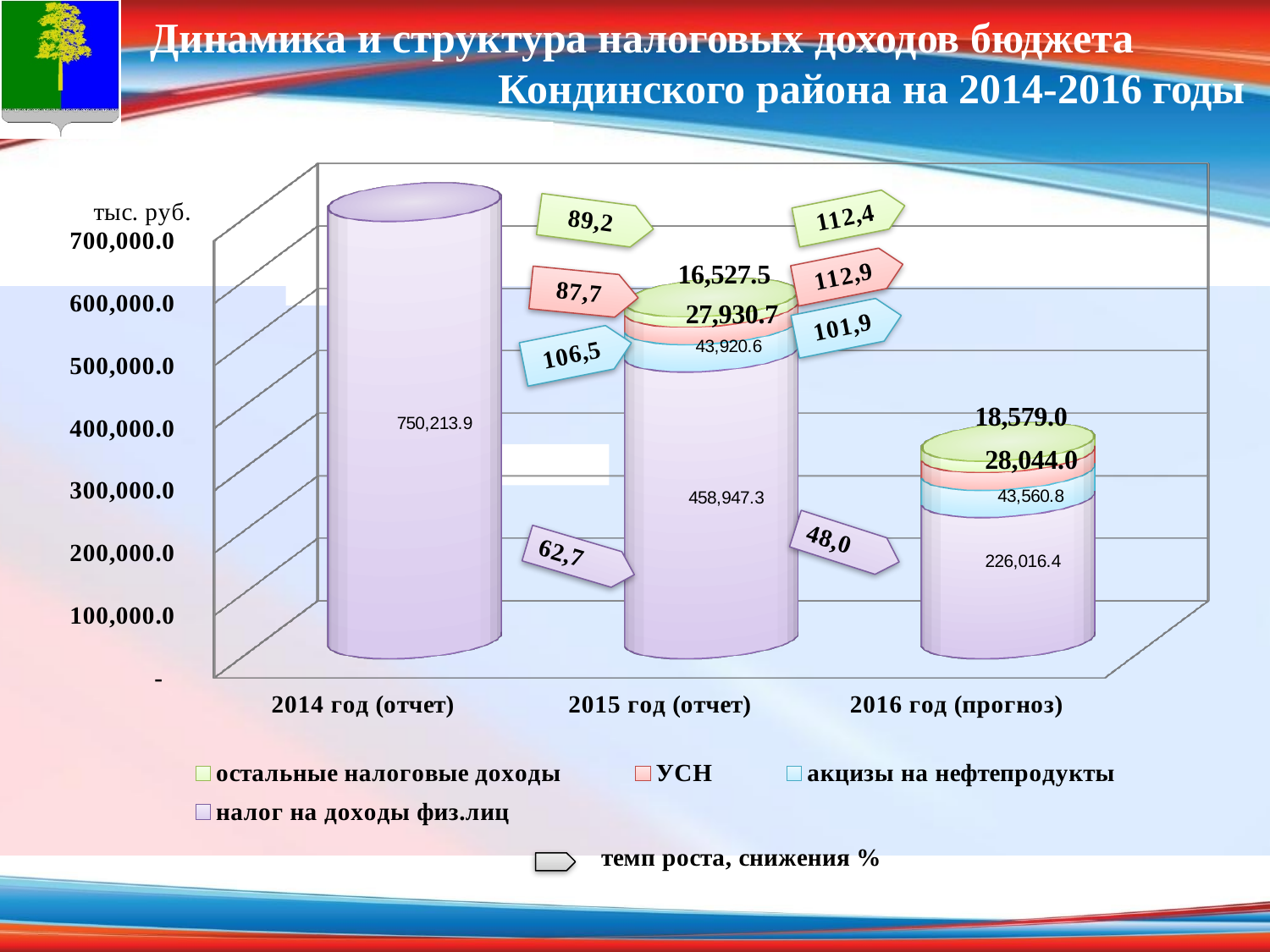
Which is larger: остальные налоговые доходы in 2015 год (отчет) or in 2016 год (прогноз)? 2016 год (прогноз) What is the difference in налог на доходы физ.лиц between 2015 год (отчет) and 2016 год (прогноз)? 232,930.9 What is the value of налог на доходы физ.лиц for 2014 год (отчет)? 750,213.9 What is the value of акцизы на нефтепродукты for 2015 год (отчет)? 43,920.6 What is the total of the stacked bar for 2016 год (прогноз)? 316,200.2 What is the value of остальные налоговые доходы for 2015 год (отчет)? 16,527.5 What is the value of УСН for 2016 год (прогноз)? 28,044.0 In which year is налог на доходы физ.лиц the highest? 2014 год (отчет) How many series does the legend list for the stacked bars? 4 What is the value of налог на доходы физ.лиц for 2016 год (прогноз)? 226,016.4 How many year categories are shown on the x axis? 3 Does налог на доходы физ.лиц rise or fall from 2014 to 2016? fall